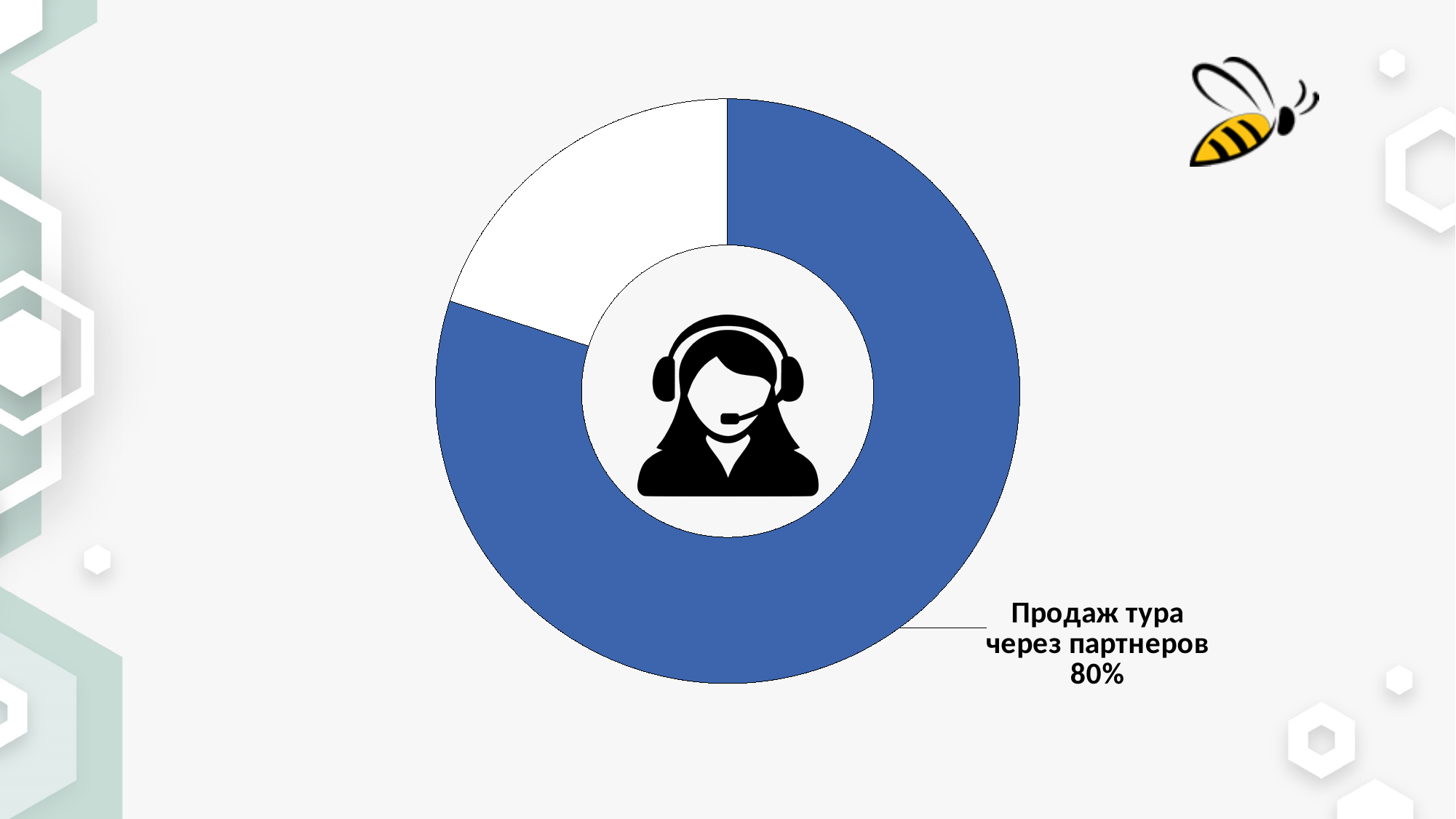
What colour is the slice labelled 'Продаж тура через партнеров'? blue How many slices does the doughnut chart have? 2 Which slice of the doughnut chart is the largest? Продаж тура через партнеров What is the label of the only labelled slice on the chart? Продаж тура через партнеров What kind of chart is shown on the slide? doughnut chart Which slice is larger, the blue slice or the white slice? the blue slice What share of the doughnut does the 'Продаж тура через партнеров' slice represent? 80% What value is shown for the slice labelled 'Продаж тура через партнеров'? 80%